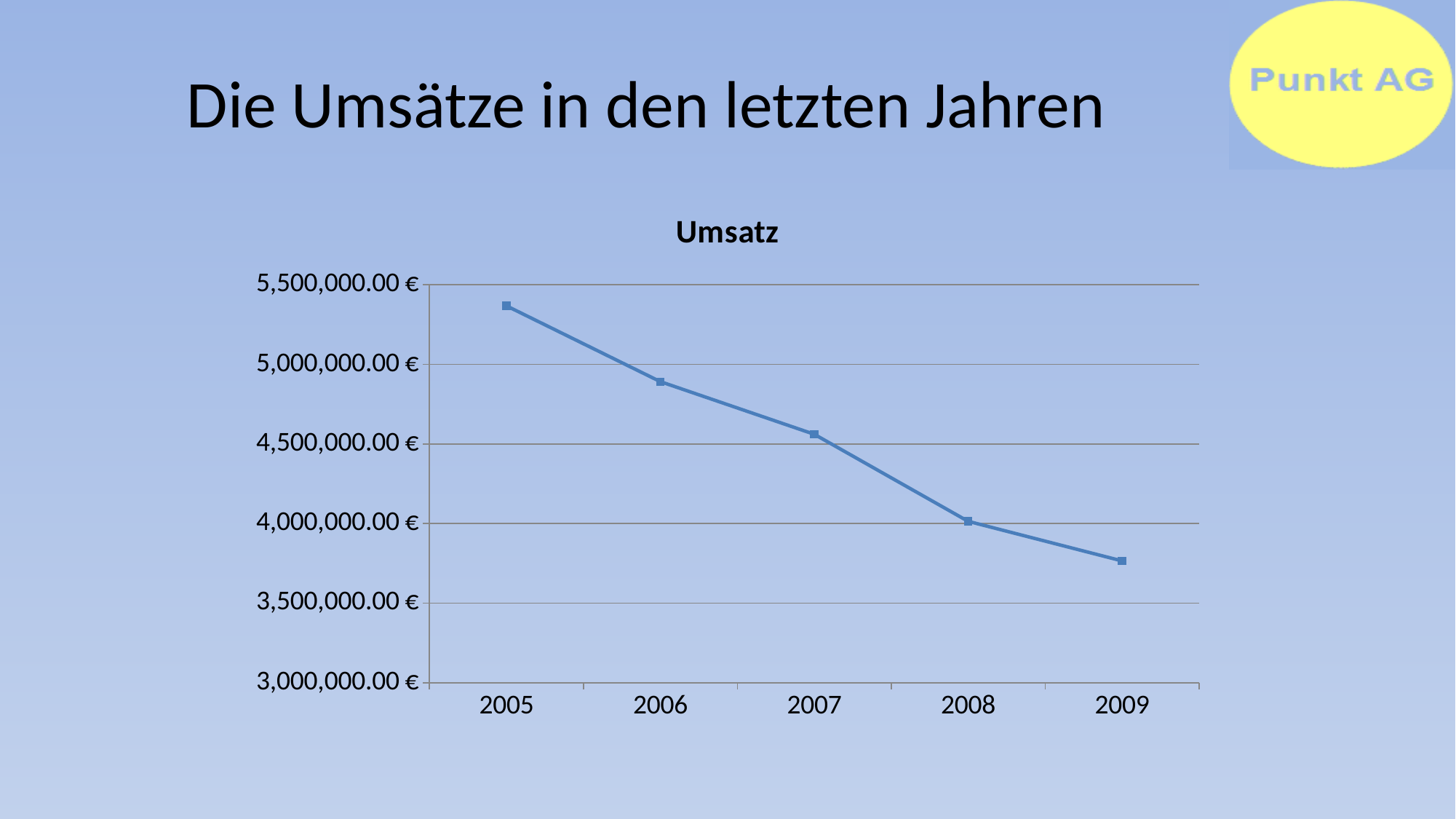
Is the Umsatz value for 2005 greater or less than 5,000,000.00 €? greater Is the Umsatz value for 2009 greater or less than 4,000,000.00 €? less How many years are plotted on the x axis of the chart? 5 Which year has the highest Umsatz value? 2005 Which year has the larger Umsatz value, 2006 or 2008? 2006 Do the Umsatz values rise or fall from 2005 to 2009? fall What kind of chart is shown on the slide? line chart Is the Umsatz value for 2008 greater or less than 4,500,000.00 €? less Which year has the lowest Umsatz value? 2009 What is the title of the chart? Umsatz